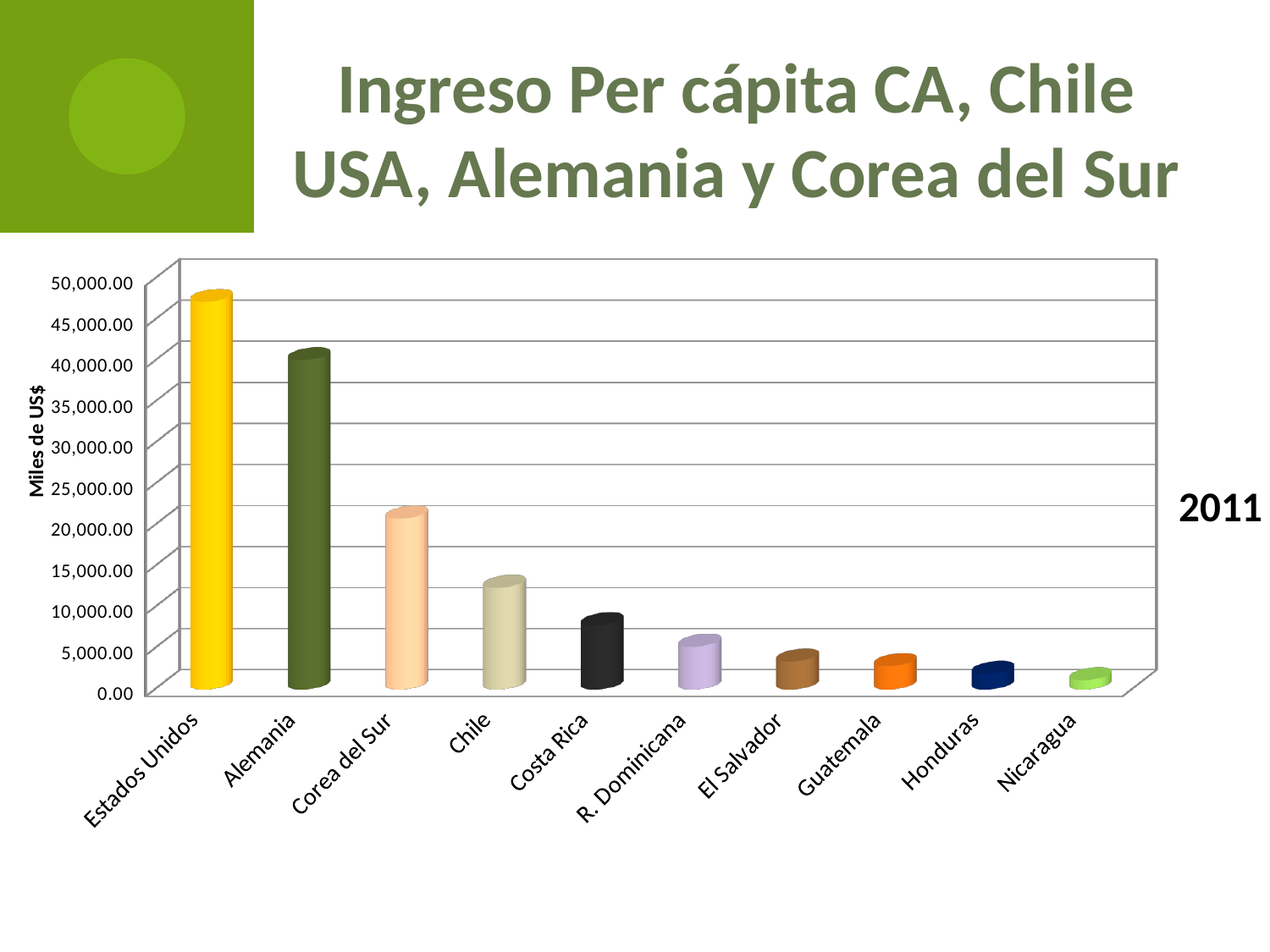
Is the value for Estados Unidos greater or less than 45,000.00? greater Which has a larger value, Chile or Costa Rica? Chile Do the values rise or fall moving from left to right along the x axis? fall Is the value for Chile greater or less than 10,000.00? greater Is the value for Corea del Sur greater or less than 25,000.00? less What kind of chart is shown on the slide? bar chart How many countries are shown on the x axis of the chart? 10 Which country has the lowest per capita income in the chart? Nicaragua Which country has the highest per capita income in the chart? Estados Unidos